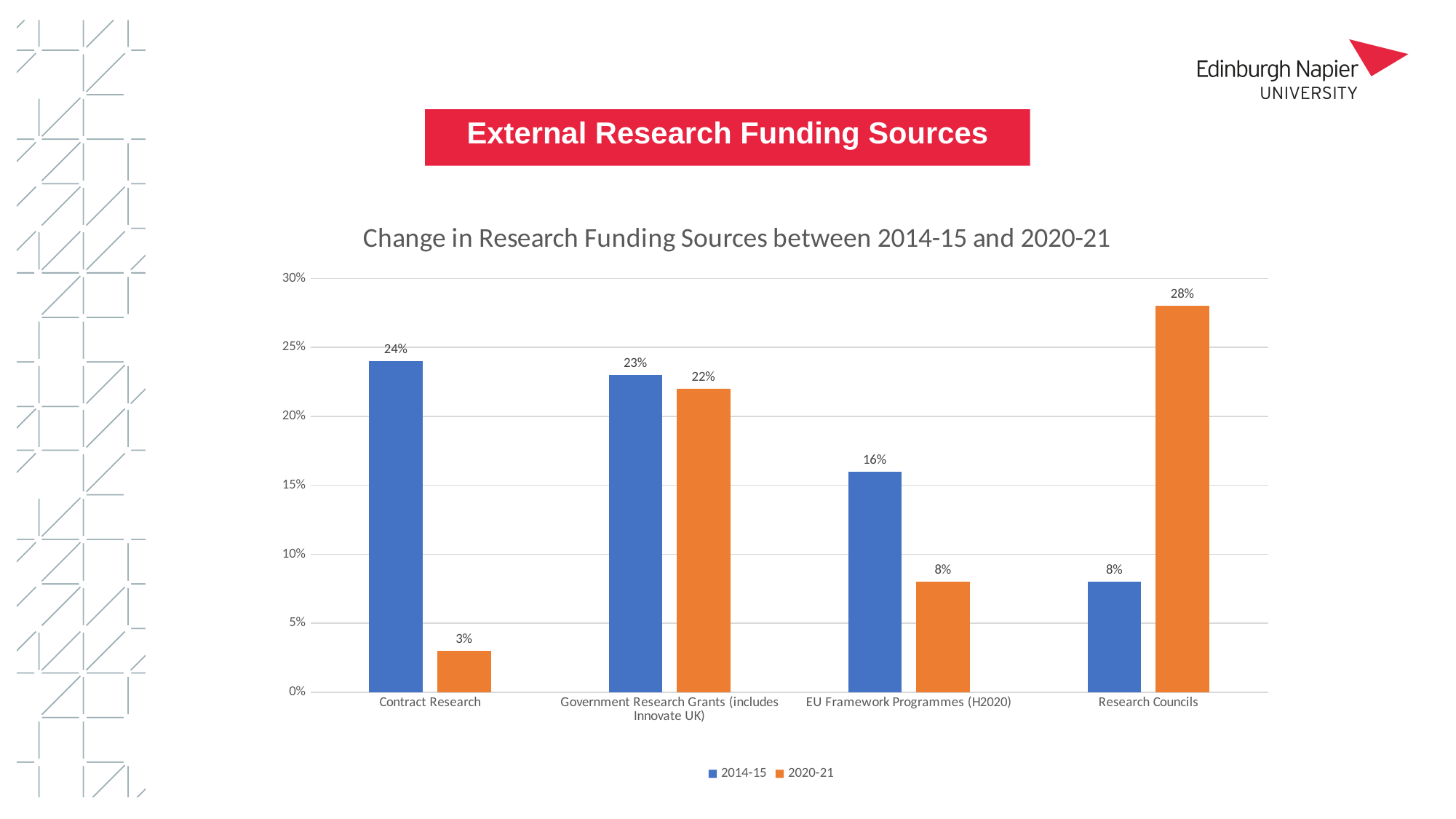
What is the 2014-15 value for Contract Research? 24% Which category has the lowest 2014-15 value? Research Councils How many series does the legend list? 2 What is the 2020-21 value for Research Councils? 28% What is the difference between the 2020-21 and 2014-15 values for Research Councils? 20% Which category has the lowest 2020-21 value? Contract Research What type of chart is shown? Bar chart What is the 2020-21 value for EU Framework Programmes (H2020)? 8% Which is larger for Government Research Grants (includes Innovate UK): the 2014-15 value or the 2020-21 value? 2014-15 How many categories are shown on the x axis? 4 Which category has the highest 2020-21 value? Research Councils What is the difference between the 2014-15 and 2020-21 values for Contract Research? 21%